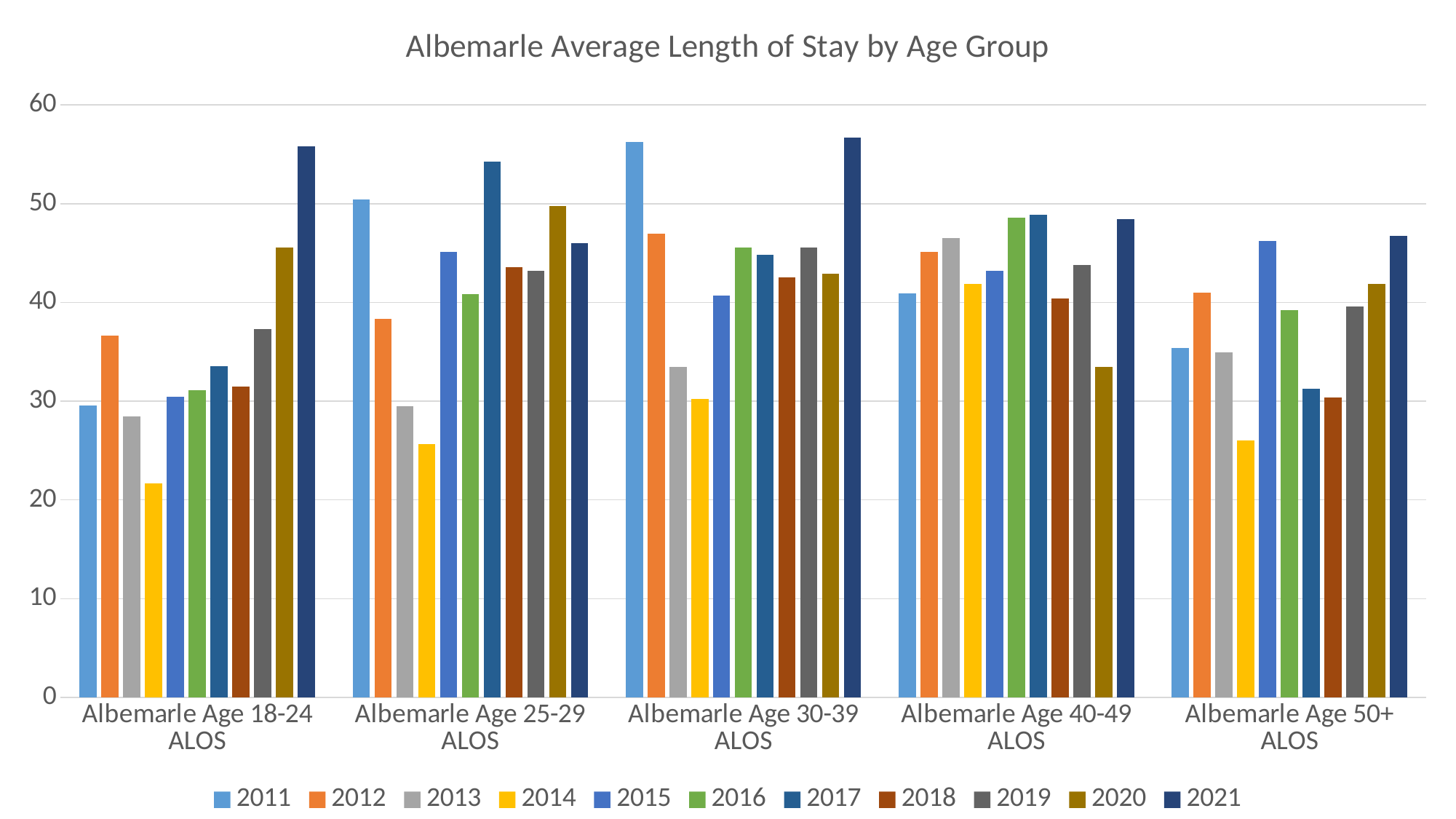
How many age-group categories are shown on the x axis? 5 Which year has the highest value for Albemarle Age 25-29 ALOS? 2017 Is the 2020 value for Albemarle Age 40-49 ALOS greater or less than 40? less How many series does the legend list? 11 What is the title of the chart? Albemarle Average Length of Stay by Age Group For Albemarle Age 50+ ALOS, which is larger, the 2012 value or the 2013 value? 2012 Is the 2014 value for Albemarle Age 18-24 ALOS greater or less than 30? less Which year has the lowest value for Albemarle Age 18-24 ALOS? 2014 For Albemarle Age 30-39 ALOS, which is larger, the 2011 value or the 2014 value? 2011 What kind of chart is shown on the slide? bar chart Is the 2021 value for Albemarle Age 18-24 ALOS greater or less than 50? greater Which year has the lowest value for Albemarle Age 50+ ALOS? 2014